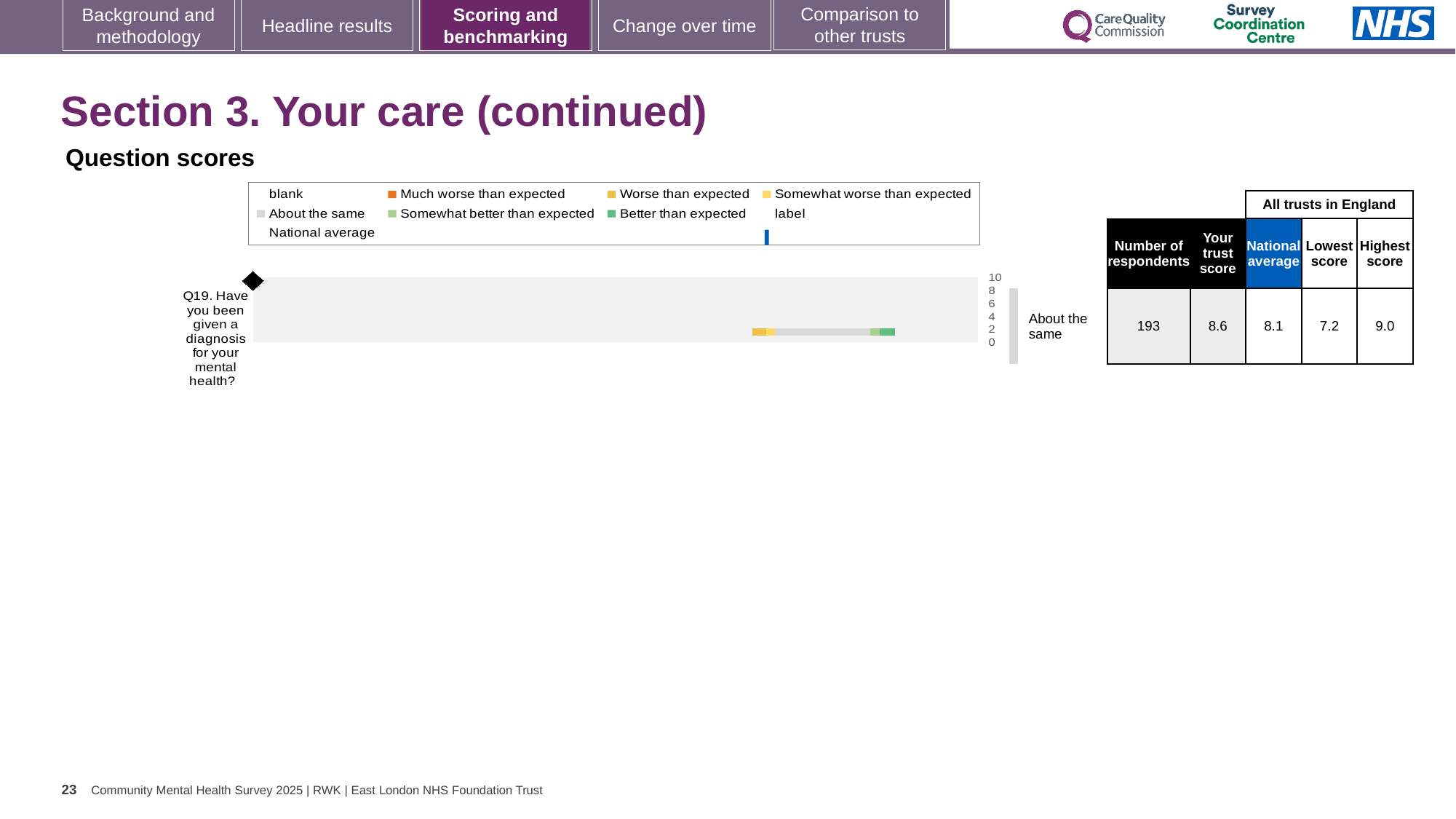
What kind of chart is used to show the Q19 question score? bar chart How many questions are plotted on the chart? 1 Which is larger for Q19: the trust score or the national average? the trust score How many respondents answered Q19? 193 What is the difference between the highest and lowest scores for Q19? 1.8 What is the lowest score among all trusts in England for Q19? 7.2 What does the blue marker in the legend represent? National average By how much does the trust score for Q19 exceed the national average? 0.5 What is the trust score for Q19 (Have you been given a diagnosis for your mental health?)? 8.6 Which benchmark category is Q19 placed in? About the same What is the national average score for Q19? 8.1 What is the highest score among all trusts in England for Q19? 9.0